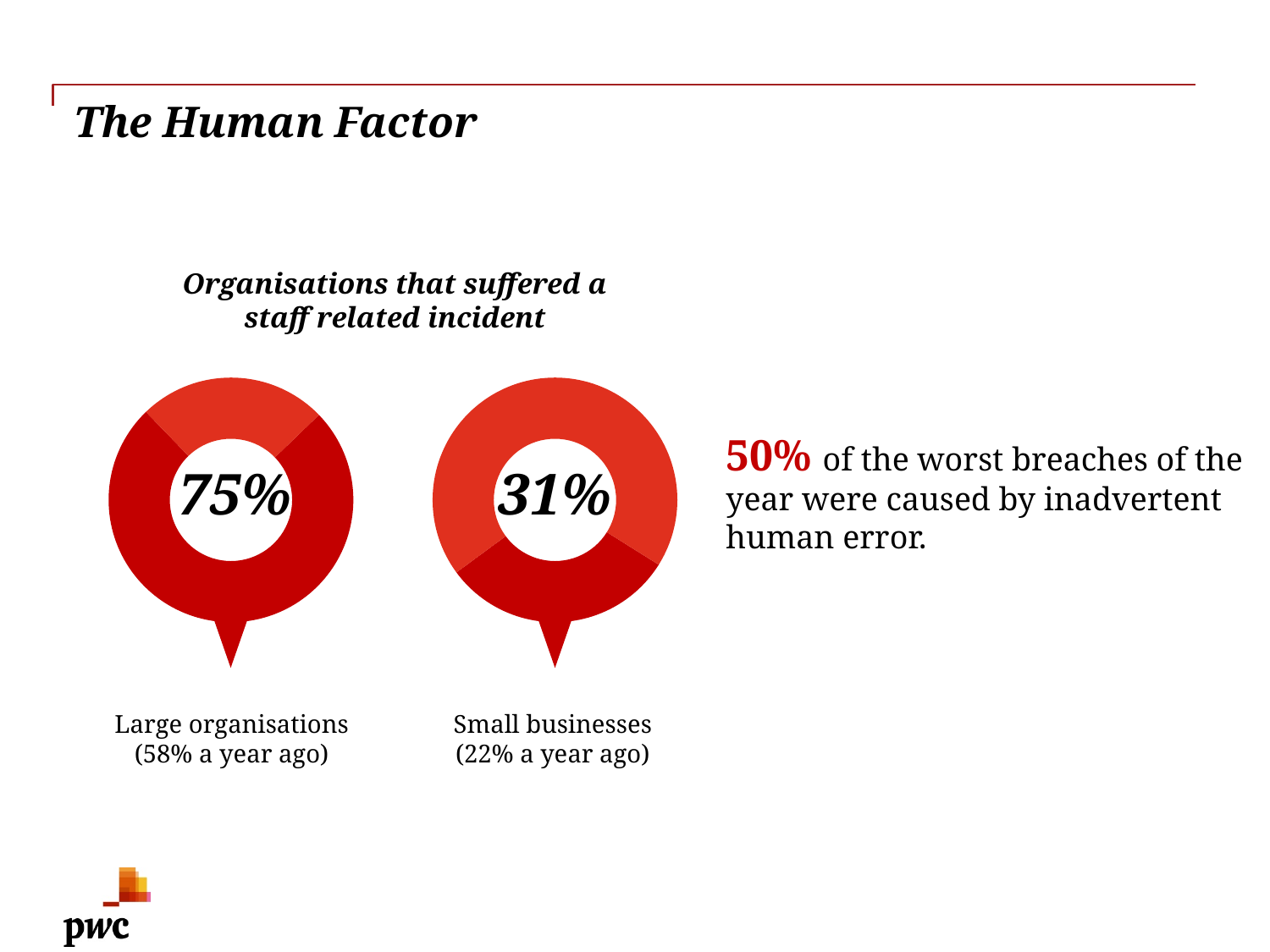
By how many percentage points did the large organisations figure rise from a year ago (58%) to now (75%)? 17 percentage points Which group has the higher share of organisations that suffered a staff related incident, large organisations or small businesses? Large organisations According to the label under the right donut chart, what was the figure for small businesses a year ago? 22% In the left donut chart, what percentage of large organisations suffered a staff related incident? 75% By how many percentage points did the small businesses figure rise from a year ago (22%) to now (31%)? 9 percentage points What is the title above the two donut charts? Organisations that suffered a staff related incident What kind of chart is used to show the percentages for large organisations and small businesses? Donut (pie) chart Did the share of organisations suffering a staff related incident rise or fall compared with a year ago for both groups? Rise What is the difference between the large organisations figure (75%) and the small businesses figure (31%)? 44 percentage points According to the label under the left donut chart, what was the figure for large organisations a year ago? 58% In the right donut chart, what percentage of small businesses suffered a staff related incident? 31% How many donut charts are shown on the slide? 2